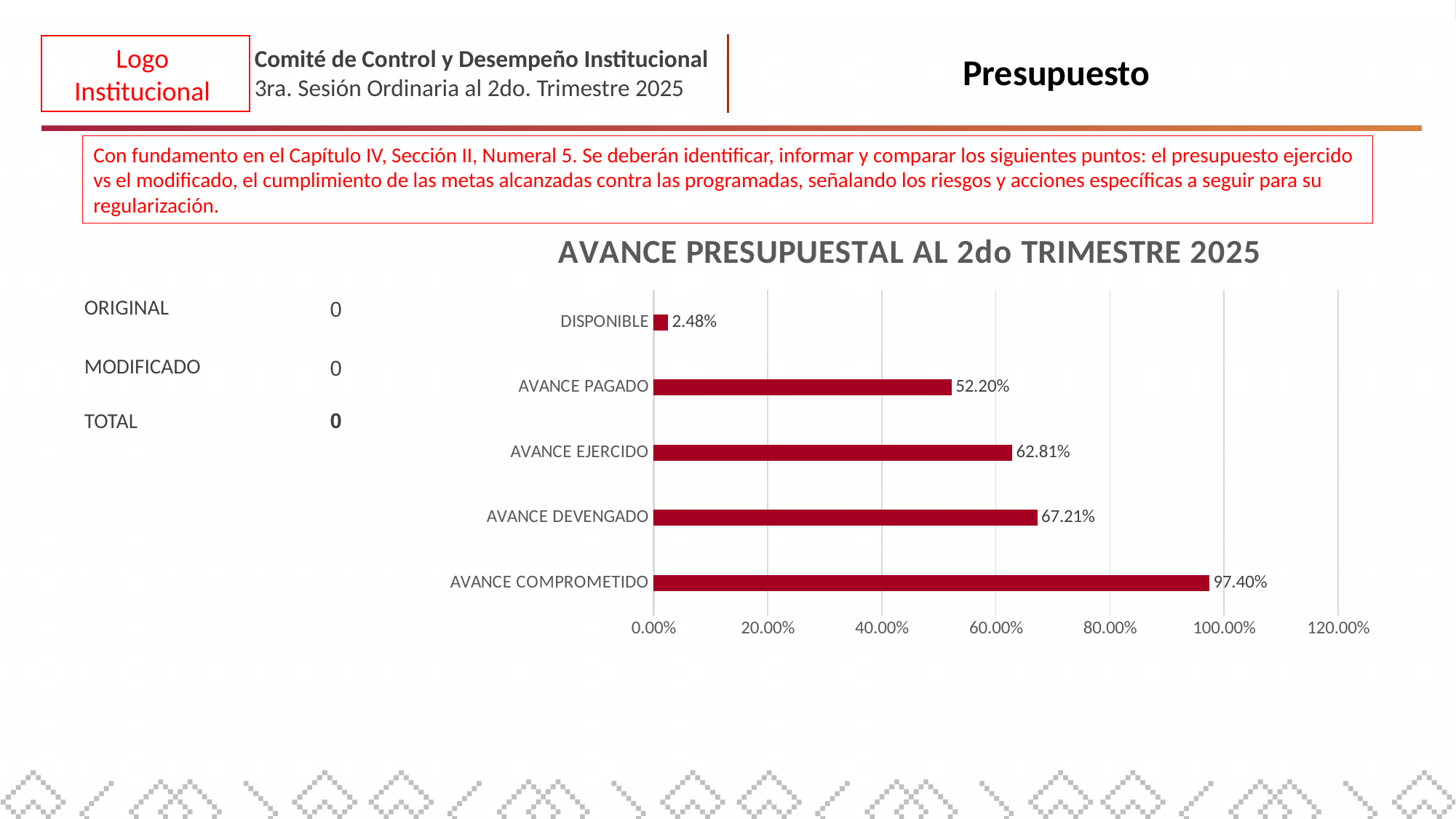
What is the value for DISPONIBLE? 2.48% What is the value for AVANCE EJERCIDO? 62.81% What is the title of the chart? AVANCE PRESUPUESTAL AL 2do TRIMESTRE 2025 What is the value for AVANCE DEVENGADO? 67.21% How many categories are shown in the chart? 5 What is the difference between AVANCE DEVENGADO and AVANCE EJERCIDO? 4.40% What is the difference between AVANCE COMPROMETIDO and AVANCE PAGADO? 45.20% Which category has the lowest value? DISPONIBLE What kind of chart is shown? Bar chart What is the value for AVANCE COMPROMETIDO? 97.40% Which is larger, AVANCE PAGADO or AVANCE EJERCIDO? AVANCE EJERCIDO Which category has the highest value? AVANCE COMPROMETIDO